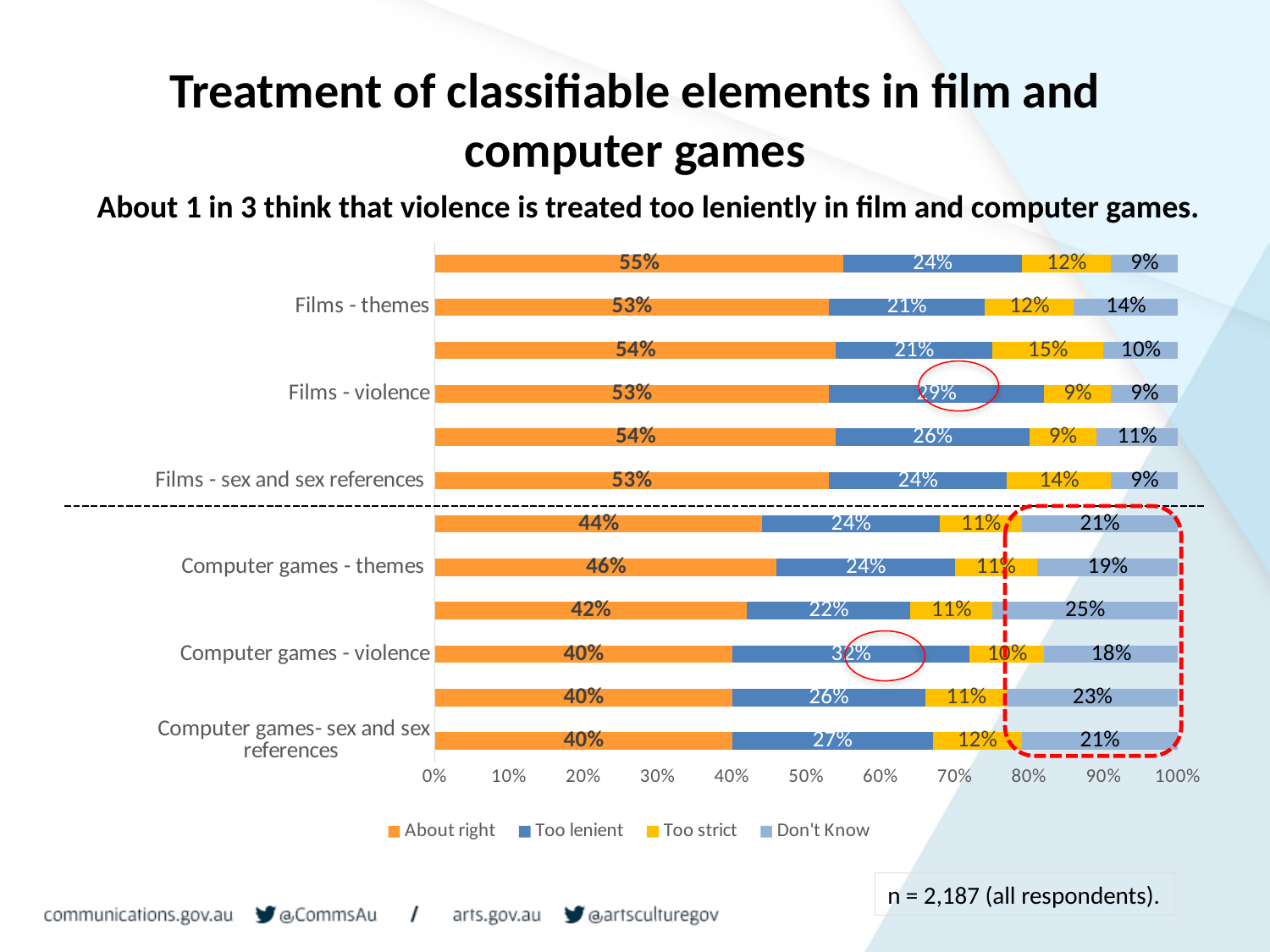
How many series does the legend list? 4 What is the difference between the 'Don't Know' values for Computer games - themes and Films - themes? 5 percentage points Which has a larger 'About right' share: Films - themes or Computer games - themes? Films - themes What is the 'Too strict' value for Films - violence? 9% What percentage said 'About right' for Computer games - violence? 40% What is the 'Don't Know' value for Films - themes? 14% What percentage of respondents said 'About right' for Films - themes? 53% What is the 'Don't Know' value for Computer games - violence? 18% What is the 'Too strict' value for Films - sex and sex references? 14% What kind of chart is shown on the slide? Stacked bar chart What percentage said 'Too lenient' for Computer games- sex and sex references? 27% What percentage said 'About right' for Computer games - themes? 46%